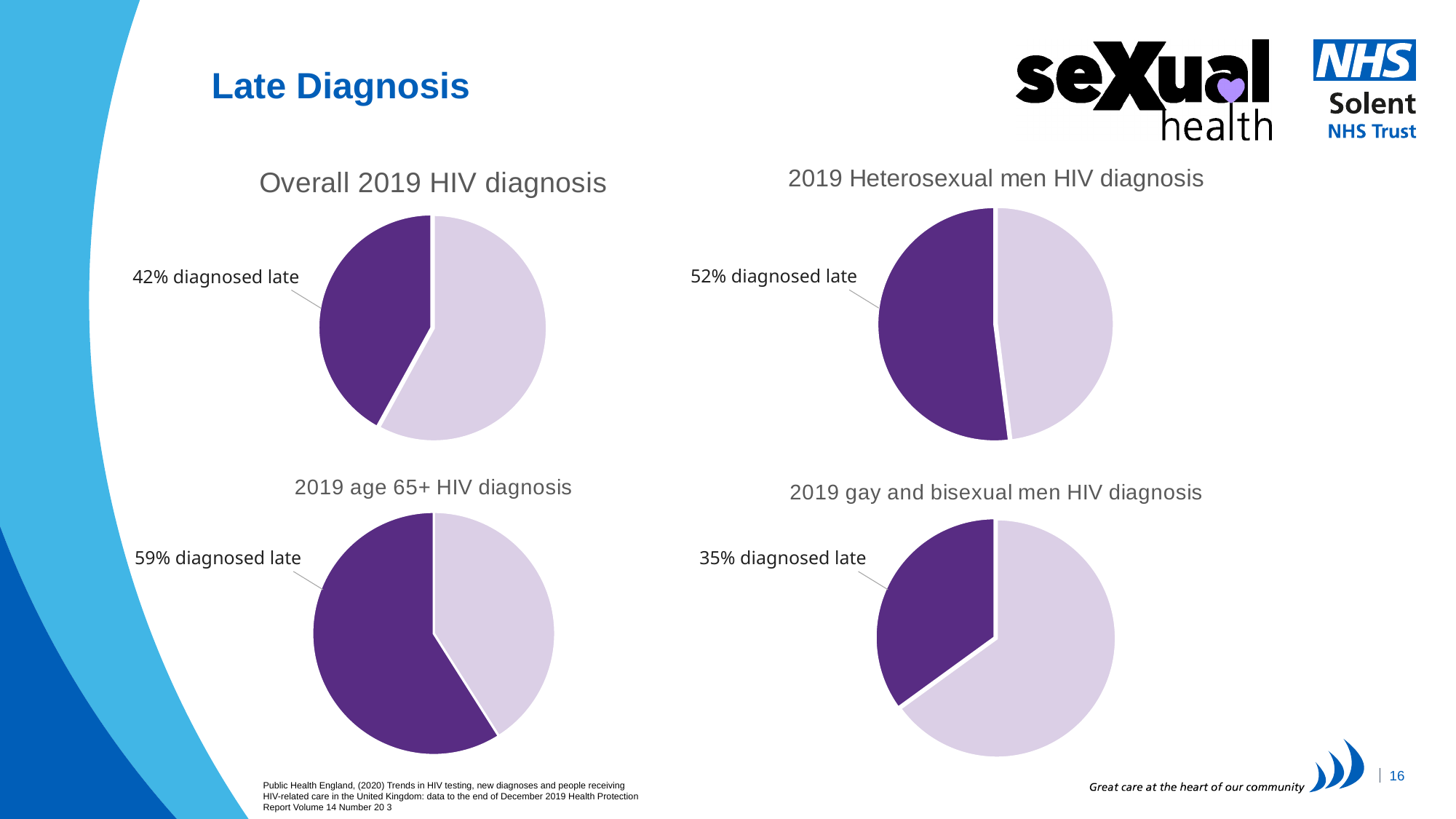
In the '2019 gay and bisexual men HIV diagnosis' chart, what percentage were diagnosed late? 35% In the 'Overall 2019 HIV diagnosis' chart, what percentage were diagnosed late? 42% How many pie charts are shown on the slide? 4 What is the difference between the late diagnosis percentage in the '2019 age 65+ HIV diagnosis' chart and the '2019 gay and bisexual men HIV diagnosis' chart? 24% Across the four charts on the slide, which group has the lowest percentage diagnosed late? 2019 gay and bisexual men What type of chart is used for the 'Overall 2019 HIV diagnosis' data? Pie chart Which is larger: the late diagnosis percentage for heterosexual men or for gay and bisexual men? Heterosexual men In the '2019 age 65+ HIV diagnosis' chart, what percentage were diagnosed late? 59% What is the difference between the late diagnosis percentage in the '2019 Heterosexual men HIV diagnosis' chart and the 'Overall 2019 HIV diagnosis' chart? 10% In the '2019 Heterosexual men HIV diagnosis' chart, what percentage were diagnosed late? 52% Across the four charts on the slide, which group has the highest percentage diagnosed late? 2019 age 65+ In the '2019 age 65+ HIV diagnosis' chart, what share of the pie does the dark purple slice represent? 59%